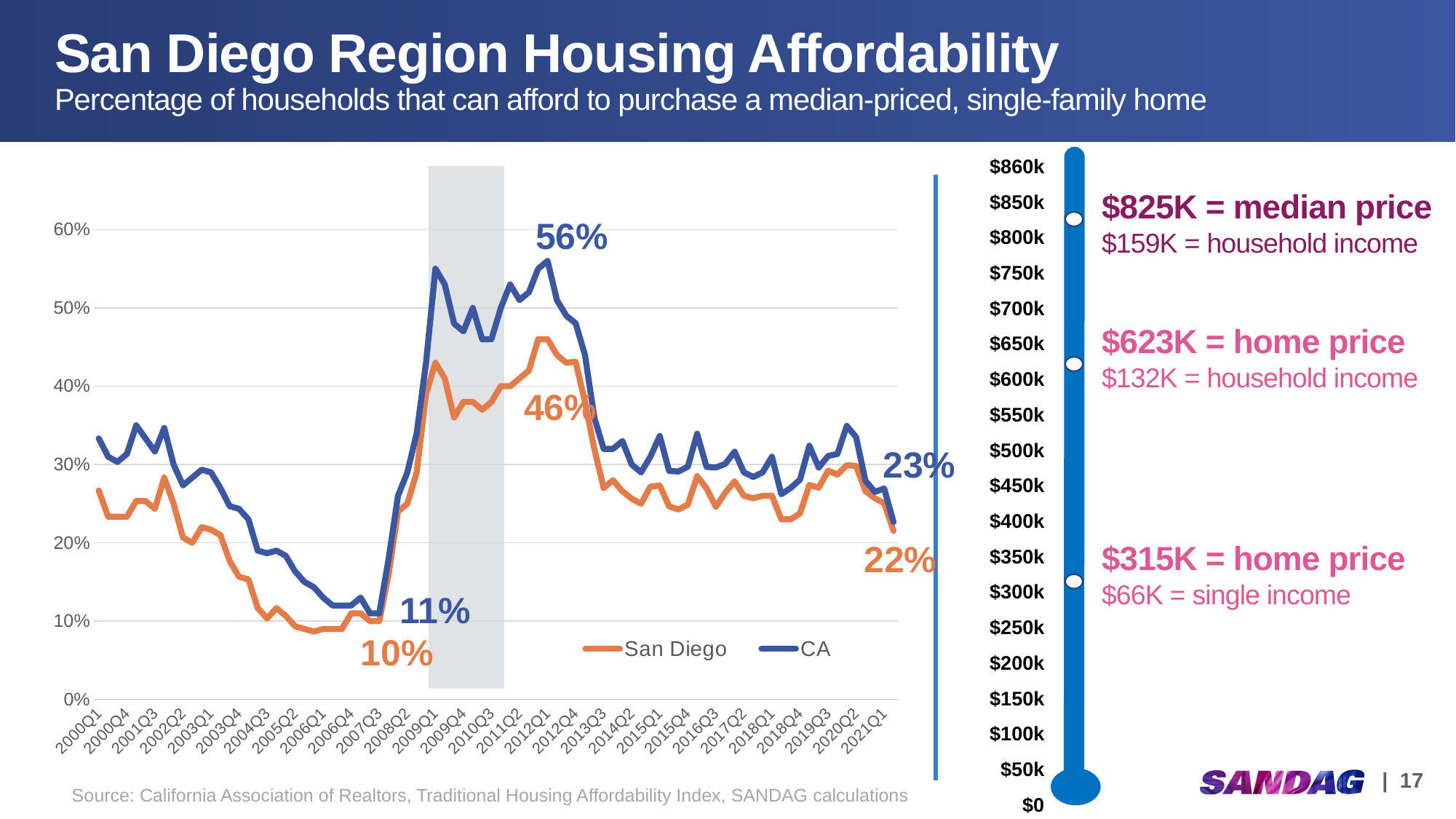
What is the lowest value labeled for the San Diego series? 10% Is the value for San Diego in 2006Q1 greater or less than 20%? less Which series has the higher labeled peak value, San Diego or CA? CA Which series is drawn in orange in the chart? San Diego What is the most recent value labeled for the San Diego series at the right end of the chart? 22% What type of chart is shown on the slide? line chart How many series does the chart legend list? 2 What is the lowest value labeled for the CA series? 11% What is the peak value labeled for the San Diego series? 46% What is the difference between the labeled CA peak (56%) and the labeled San Diego peak (46%)? 10% What is the most recent value labeled for the CA series at the right end of the chart? 23% What is the peak value labeled for the CA series? 56%